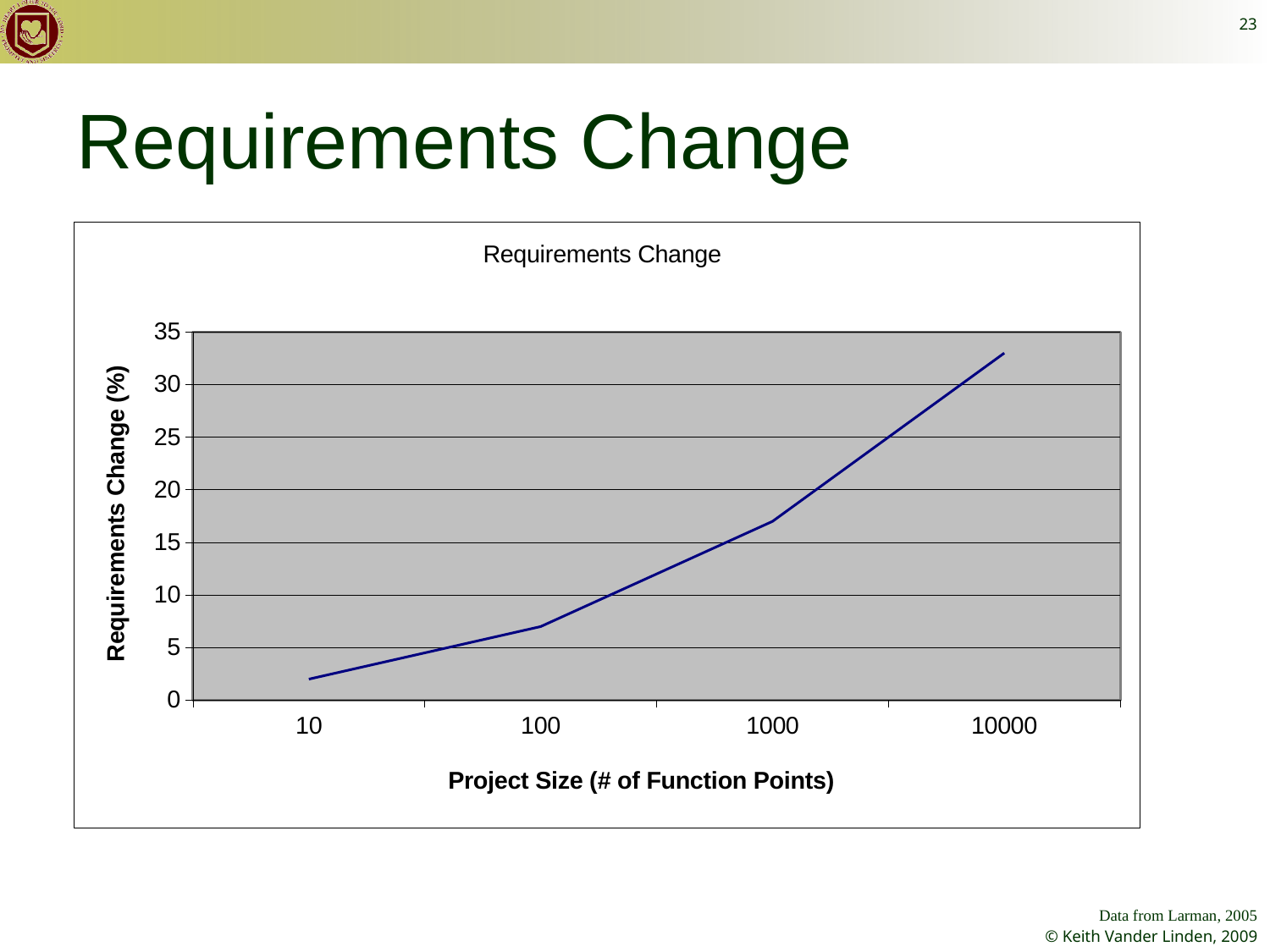
Which project size has the highest requirements change? 10000 How many project size categories are plotted on the x axis? 4 Which has a larger requirements change, a project size of 100 or a project size of 1000? 1000 What kind of chart is shown on the slide? line chart What is the label of the x axis? Project Size (# of Function Points) Is the requirements change for a project size of 100 greater or less than 10? less What is the title of the chart? Requirements Change Is the requirements change for a project size of 10000 greater or less than 30? greater Does the requirements change rise or fall as project size increases along the x axis? rise Which project size has the lowest requirements change? 10 Is the requirements change for a project size of 1000 greater or less than 15? greater